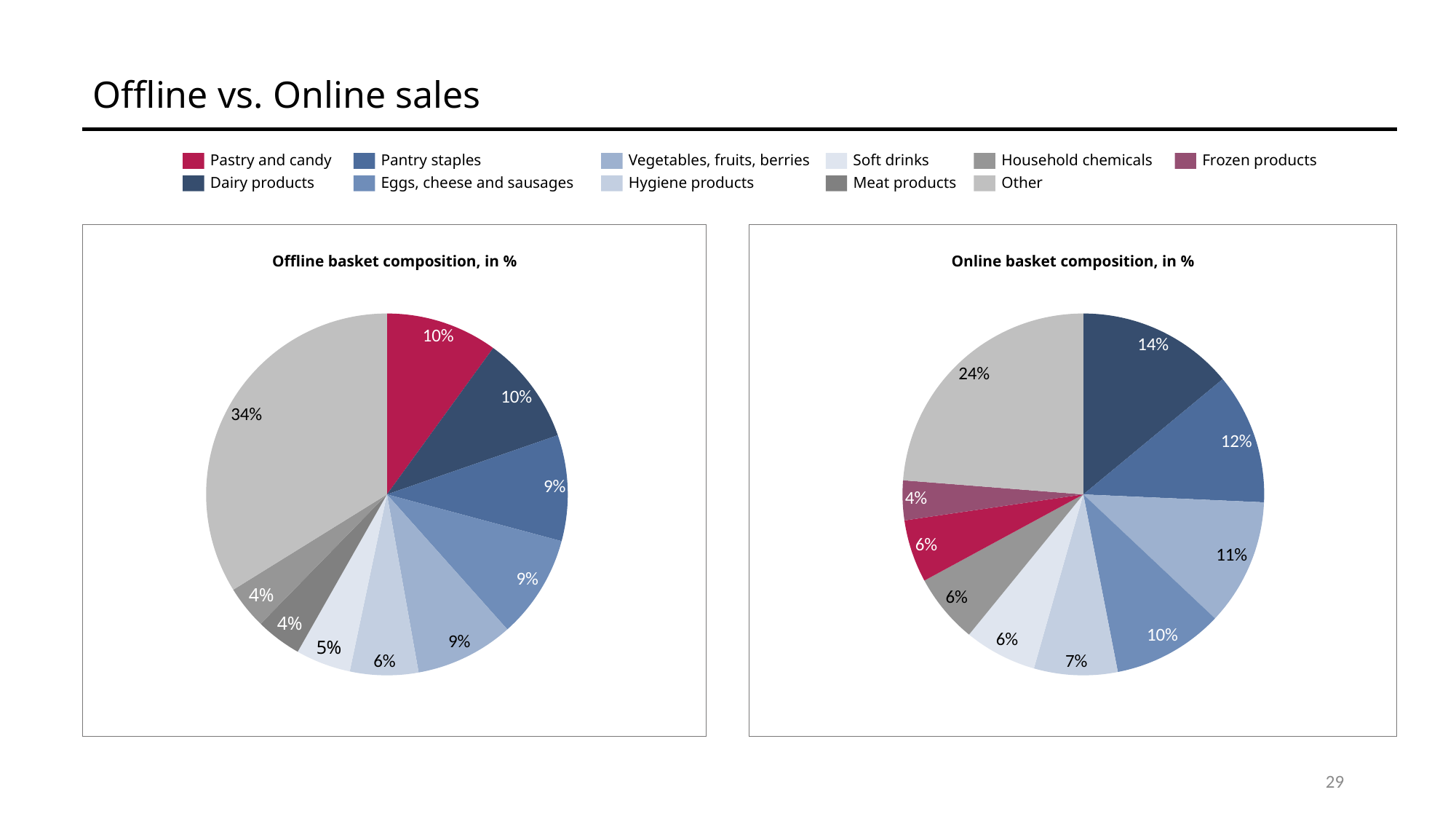
In the Offline basket composition chart, what is the share for Pastry and candy? 10% How many slices does the Online basket composition pie chart have? 10 In the Online basket composition chart, which category has the smallest slice? Frozen products In the Online basket composition chart, what share does the Other slice have? 24% What kind of chart is the Offline basket composition chart? pie chart In the Online basket composition chart, what is the share for Frozen products? 4% In the Offline basket composition chart, which category has the largest slice? Other Is the Pastry and candy share larger in the Offline basket composition chart or the Online basket composition chart? Offline basket composition In the Online basket composition chart, what is the share for Dairy products? 14% In the Online basket composition chart, what is the share for Pastry and candy? 6% What is the difference between the Other share in the Offline basket composition chart and the Other share in the Online basket composition chart? 10 percentage points In the Offline basket composition chart, what share does the Other slice have? 34%